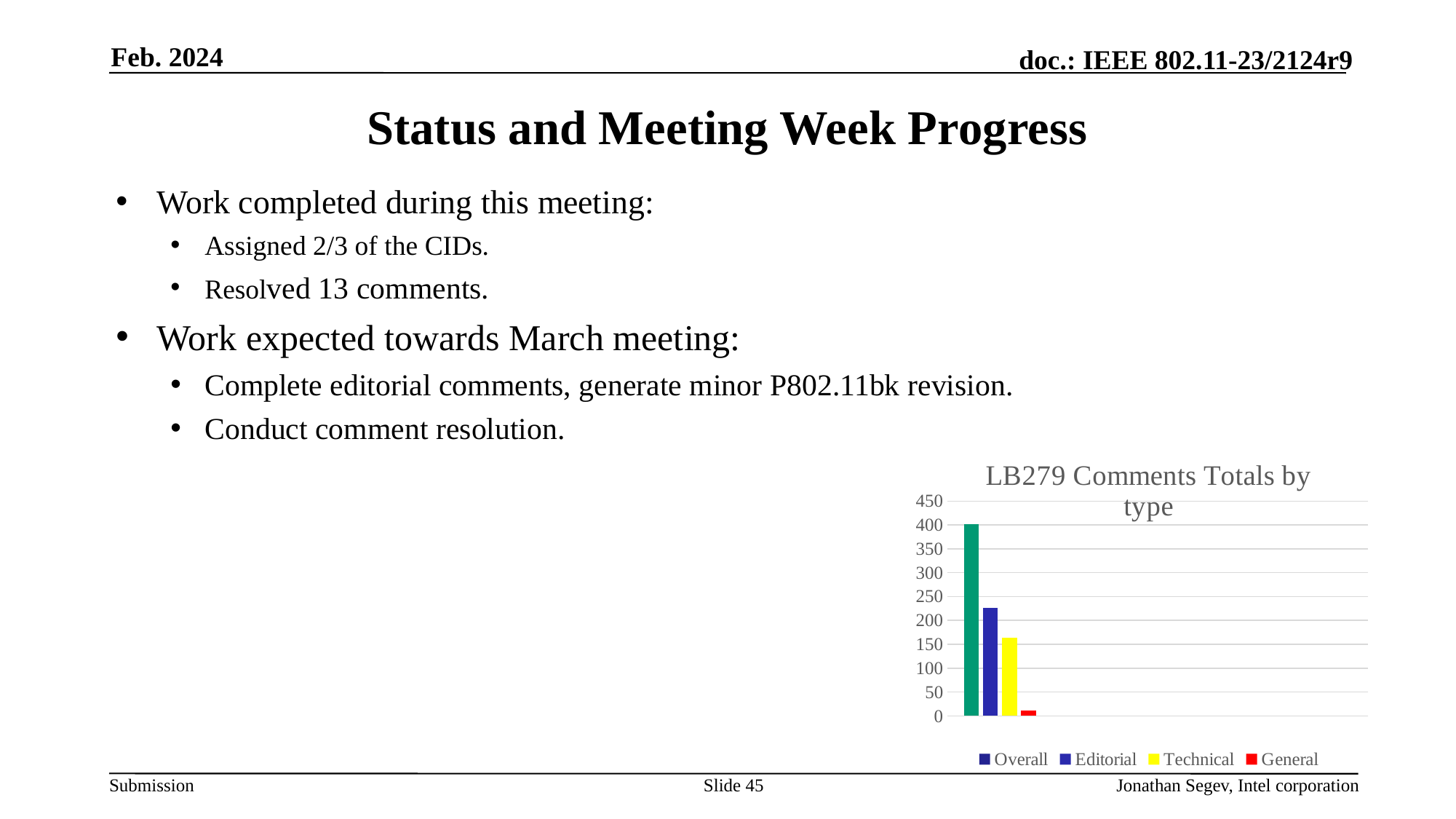
Is the value for Technical greater or less than 200? less What colour is the bar for the Technical series? yellow Which series has the highest value in the chart? Overall Which is larger, the value for Technical or the value for General? Technical Is the value for General greater or less than 50? less What is the title of the chart on the slide? LB279 Comments Totals by type How many series does the chart legend list? 4 Which is larger, the value for Editorial or the value for Technical? Editorial Which series has the lowest value in the chart? General Is the value for Overall greater or less than 350? greater What kind of chart is shown on the slide? bar chart